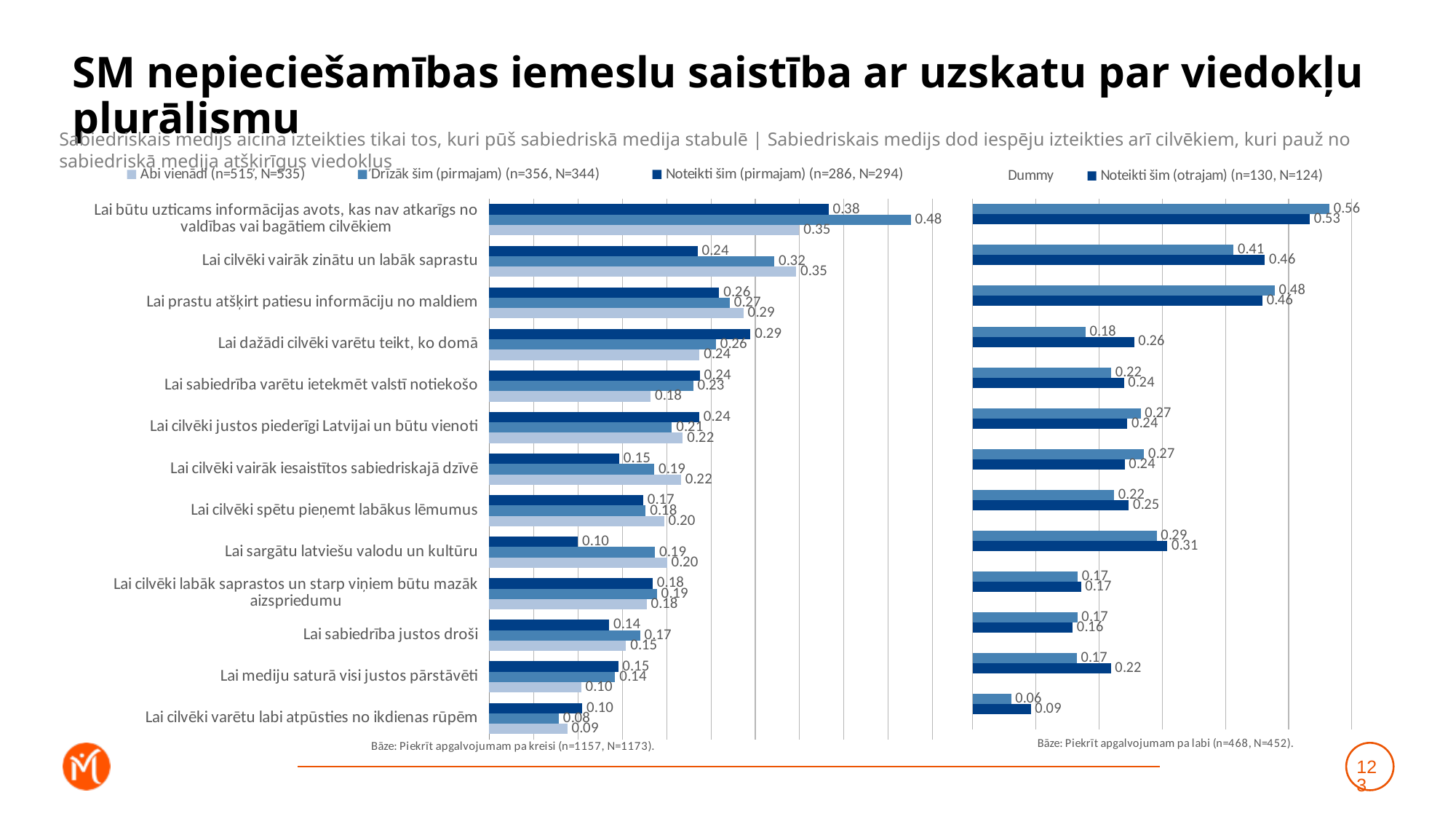
In the left chart, what is the difference between the 'Drīzāk šim (pirmajam)' and 'Noteikti šim (pirmajam)' values for 'Lai būtu uzticams informācijas avots, kas nav atkarīgs no valdības vai bagātiem cilvēkiem'? 0.10 In the right chart, which category has the lowest value for 'Noteikti šim (otrajam)'? Lai cilvēki varētu labi atpūsties no ikdienas rūpēm How many categories are shown in the left chart? 13 What type of chart is shown on the left side of the slide? bar chart In the left chart, what is the value of 'Noteikti šim (pirmajam)' for 'Lai sargātu latviešu valodu un kultūru'? 0.10 In the left chart, which category has the highest value for 'Noteikti šim (pirmajam)'? Lai būtu uzticams informācijas avots, kas nav atkarīgs no valdības vai bagātiem cilvēkiem How many series does the legend of the left chart list? 3 In the left chart, what is the value of 'Drīzāk šim (pirmajam)' for 'Lai būtu uzticams informācijas avots, kas nav atkarīgs no valdības vai bagātiem cilvēkiem'? 0.48 In the right chart, what is the value of 'Noteikti šim (otrajam)' for 'Lai būtu uzticams informācijas avots, kas nav atkarīgs no valdības vai bagātiem cilvēkiem'? 0.53 In the left chart, which category has the lowest value for 'Drīzāk šim (pirmajam)'? Lai cilvēki varētu labi atpūsties no ikdienas rūpēm In the left chart, what is the value of 'Abi vienādi' for 'Lai cilvēki vairāk zinātu un labāk saprastu'? 0.35 In the left chart, which is larger for 'Lai dažādi cilvēki varētu teikt, ko domā': 'Noteikti šim (pirmajam)' or 'Abi vienādi'? Noteikti šim (pirmajam)